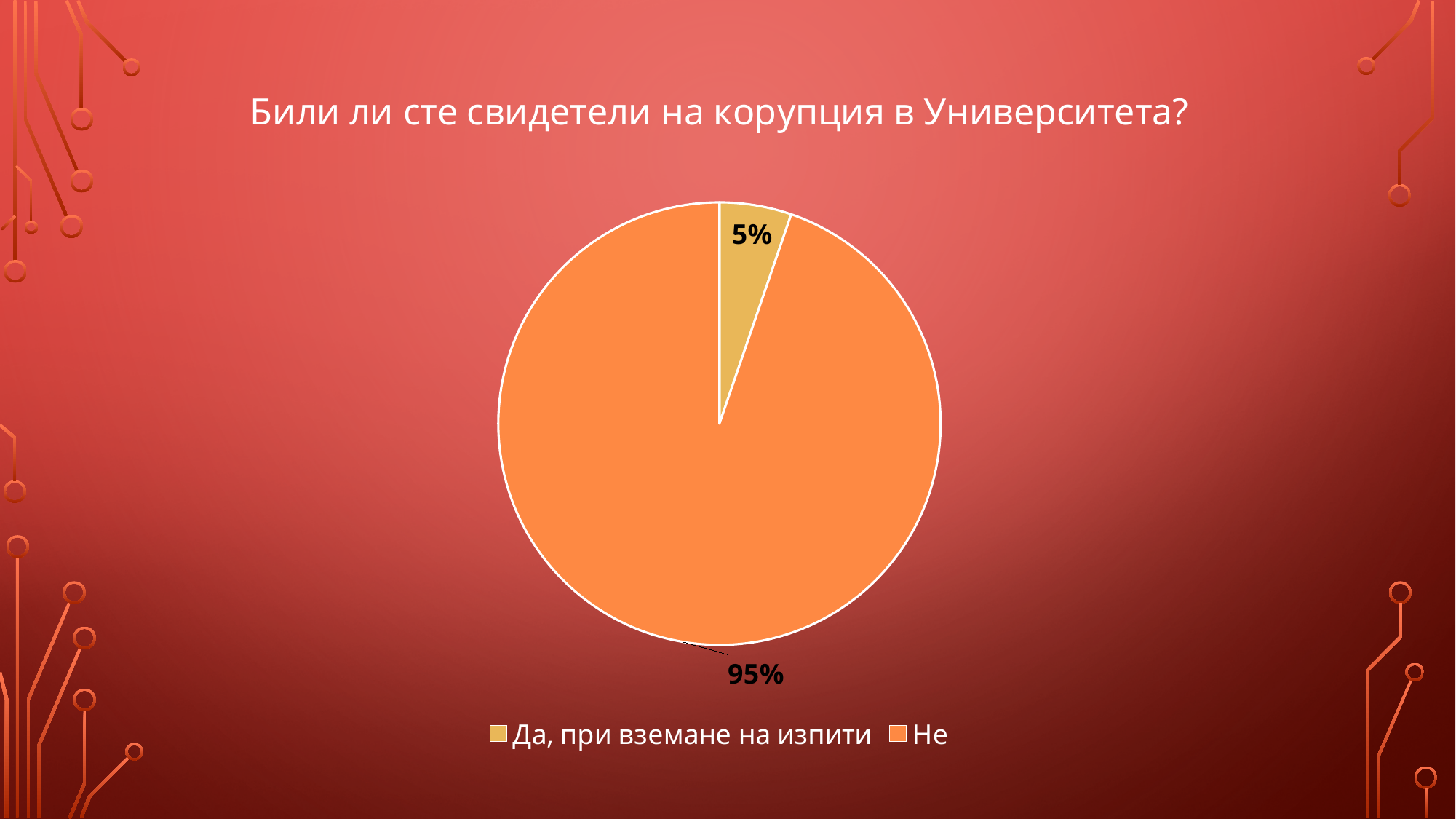
How many slices does the pie chart have? 2 What is the difference between the values for "Не" and "Да, при вземане на изпити"? 90% What share of the pie does "Не" take? 95% How many entries does the legend list? 2 What kind of chart is shown on the slide? pie chart What is the value for "Да, при вземане на изпити"? 5% What is the value for "Не"? 95% Which is larger, the slice for "Не" or the slice for "Да, при вземане на изпити"? Не What colour is the slice for "Не"? orange Which category has the smallest slice? Да, при вземане на изпити Which category has the largest slice? Не What is the title of the chart? Били ли сте свидетели на корупция в Университета?